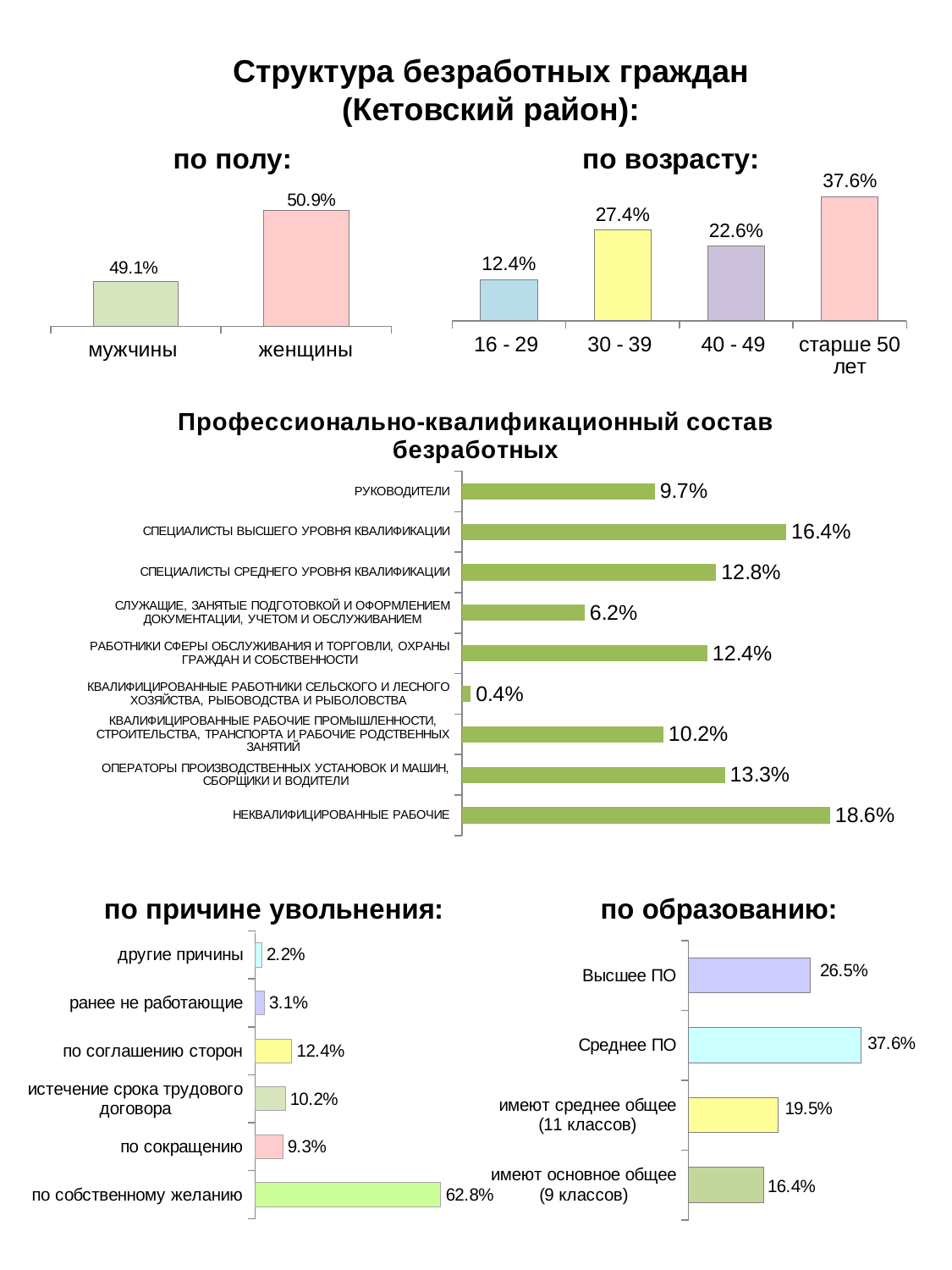
In the 'Профессионально-квалификационный состав безработных' chart, what is the value for РУКОВОДИТЕЛИ? 9.7% In the 'по возрасту' chart, what is the value for 30 - 39? 27.4% In the 'по образованию' chart, which is larger: Высшее ПО or Среднее ПО? Среднее ПО What type of chart is the 'по образованию' chart? bar chart In the 'по возрасту' chart, which age group has the highest value? старше 50 лет In the 'Профессионально-квалификационный состав безработных' chart, which category has the lowest value? КВАЛИФИЦИРОВАННЫЕ РАБОТНИКИ СЕЛЬСКОГО И ЛЕСНОГО ХОЗЯЙСТВА, РЫБОВОДСТВА И РЫБОЛОВСТВА In the 'по причине увольнения' chart, what is the value for по сокращению? 9.3% How many categories are shown in the 'Профессионально-квалификационный состав безработных' chart? 9 In the 'по возрасту' chart, what is the difference between the values for старше 50 лет and 16 - 29? 25.2% In the 'по полу' chart, what is the value for женщины? 50.9% In the 'по образованию' chart, what is the value for имеют основное общее (9 классов)? 16.4% In the 'по причине увольнения' chart, which category has the highest value? по собственному желанию